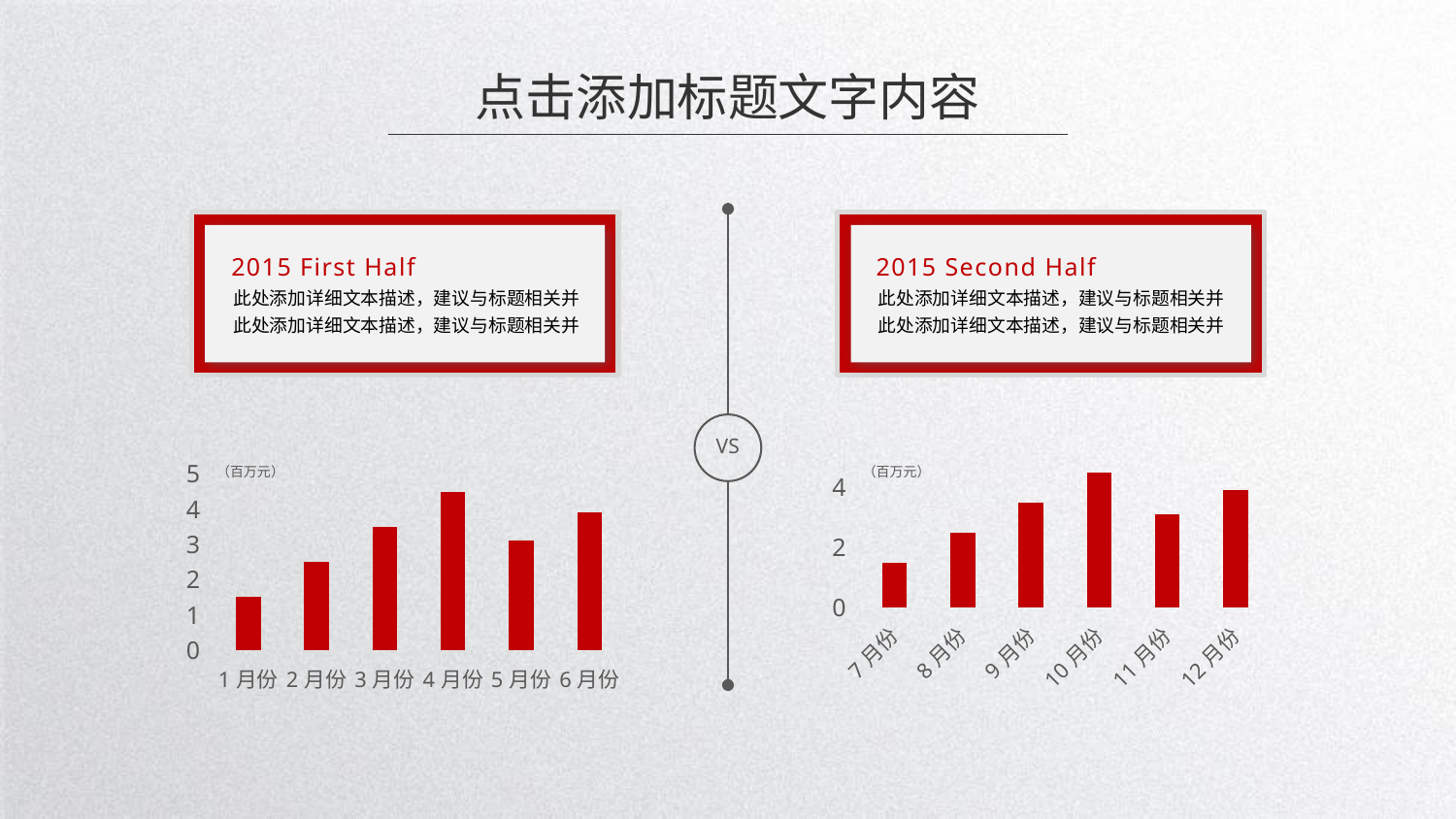
In the left chart, which month has the lowest bar? 1 月份 In the left chart, which month has the highest bar? 4 月份 In the right chart, which month has the lowest bar? 7 月份 In the right chart, is the value for 7 月份 greater or less than 2? less What kind of chart is the left chart (below "2015 First Half")? bar chart What unit label is shown at the top of the y axis of the left chart? 百万元 In the left chart, is the value for 1 月份 greater or less than 2? less How many months are shown on the x axis of the left chart? 6 In the right chart, which month has the highest bar? 10 月份 In the left chart, which is larger, the value for 3 月份 or the value for 5 月份? 3 月份 How many months are shown on the x axis of the right chart (below "2015 Second Half")? 6 In the left chart, is the value for 4 月份 greater or less than 4? greater